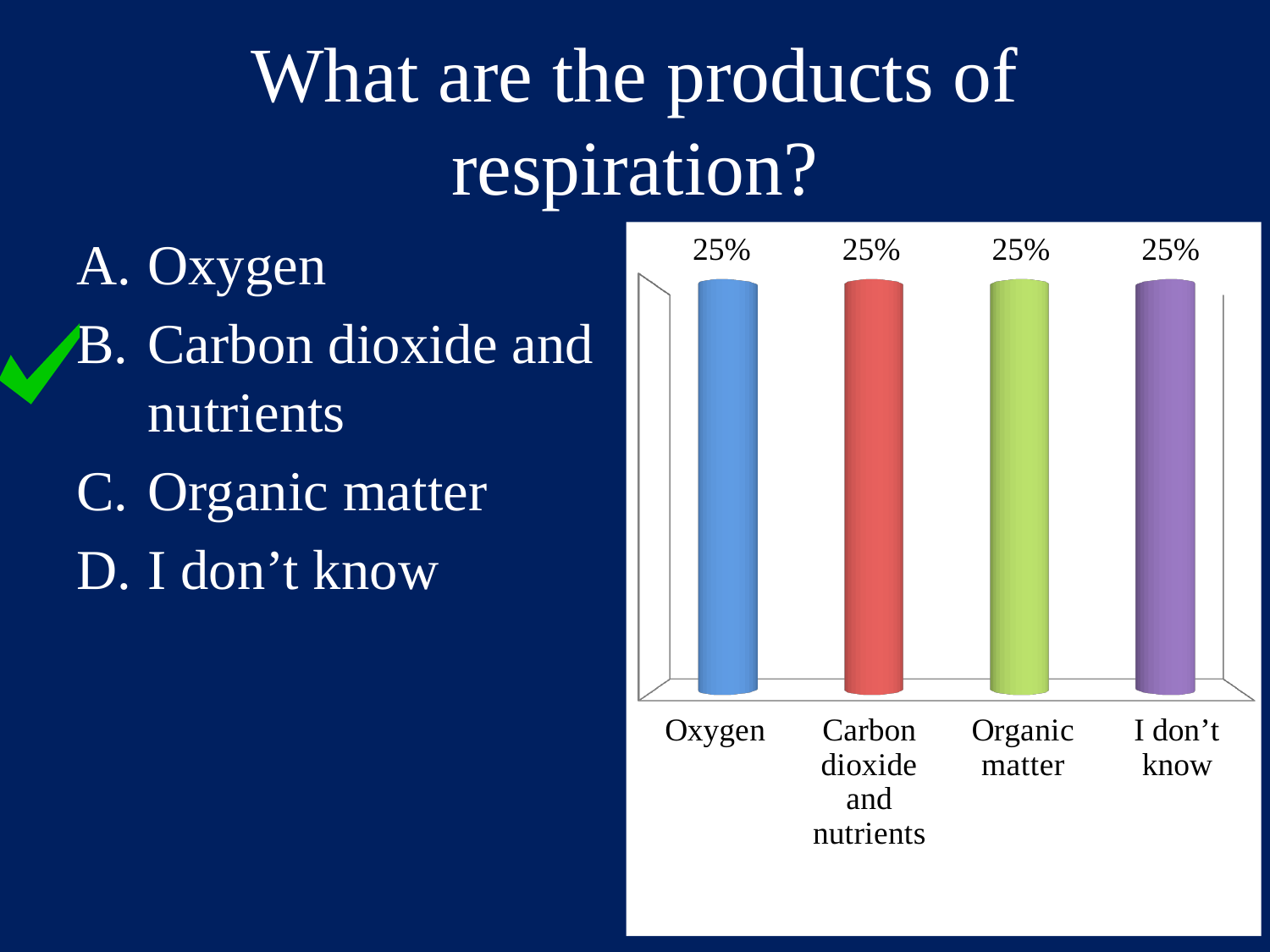
What is the value for I don't know? 25% What is the difference between the values for Oxygen and Organic matter? 0% What is the value for Oxygen? 25% What kind of chart is shown on the slide? bar chart What is the value for Organic matter? 25% Do the values rise, fall, or stay the same across the categories from left to right? stay the same What colour is the bar for I don't know? purple What colour is the bar for Carbon dioxide and nutrients? red What is the total of all four values shown on the chart? 100% How many categories are shown on the chart? 4 What is the value for Carbon dioxide and nutrients? 25%